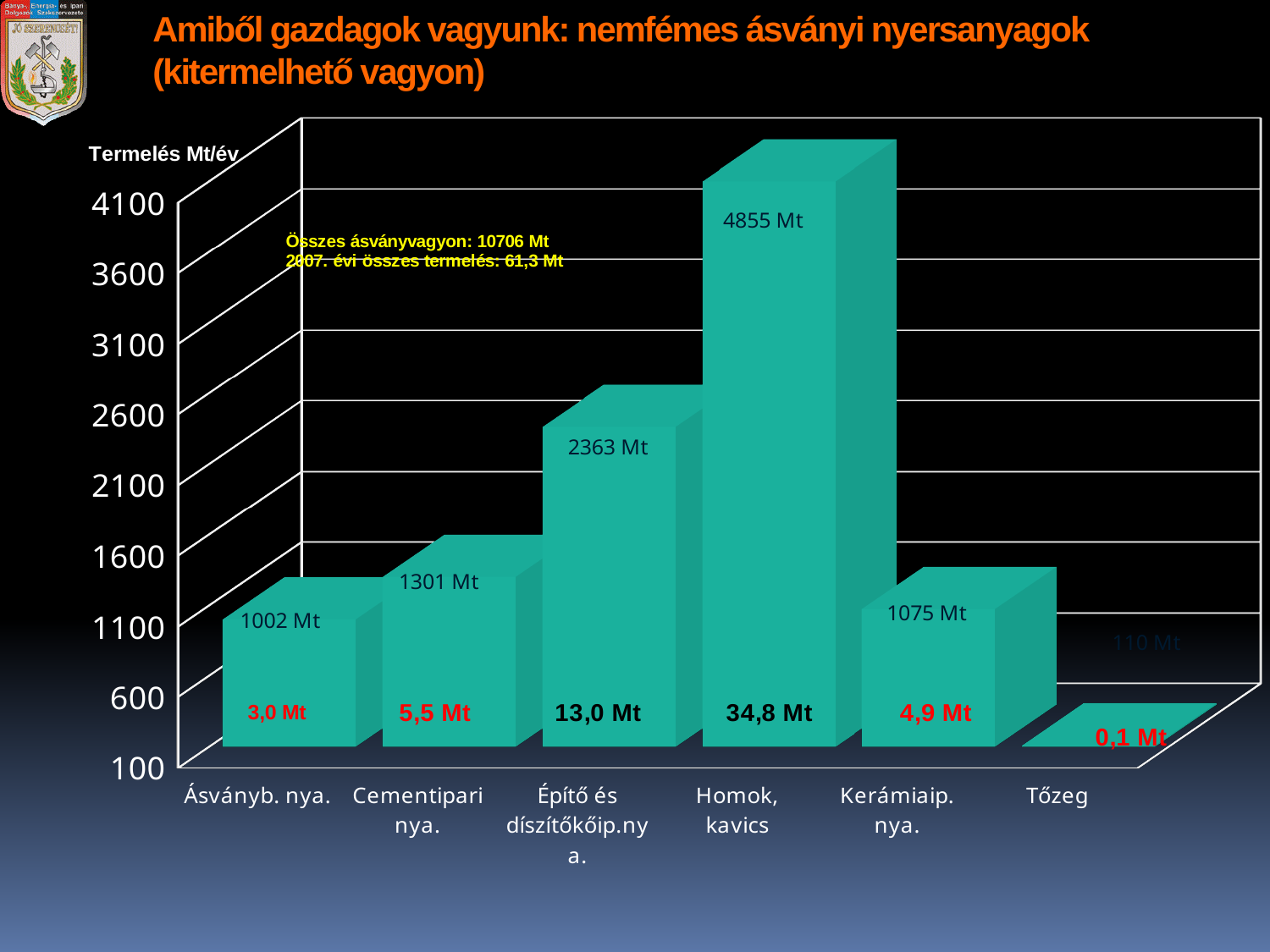
Which category has the lowest value? Tőzeg Which is larger, the value for Cementipari nya. or the value for Kerámiaip. nya.? Cementipari nya. How many categories are shown on the x axis? 6 What is the value shown for Tőzeg? 110 Mt What production figure (Mt/év) is printed on the bar for Homok, kavics? 34,8 Mt Which category has the highest value? Homok, kavics What is the value shown for Cementipari nya.? 1301 Mt What total mineral wealth (Összes ásványvagyon) is stated in the text on the chart? 10706 Mt What is the value shown for Kerámiaip. nya.? 1075 Mt What kind of chart is shown on the slide? Bar chart What is the value shown for Homok, kavics? 4855 Mt What is the difference between the values for Homok, kavics and Építő és díszítőkőip.nya.? 2492 Mt